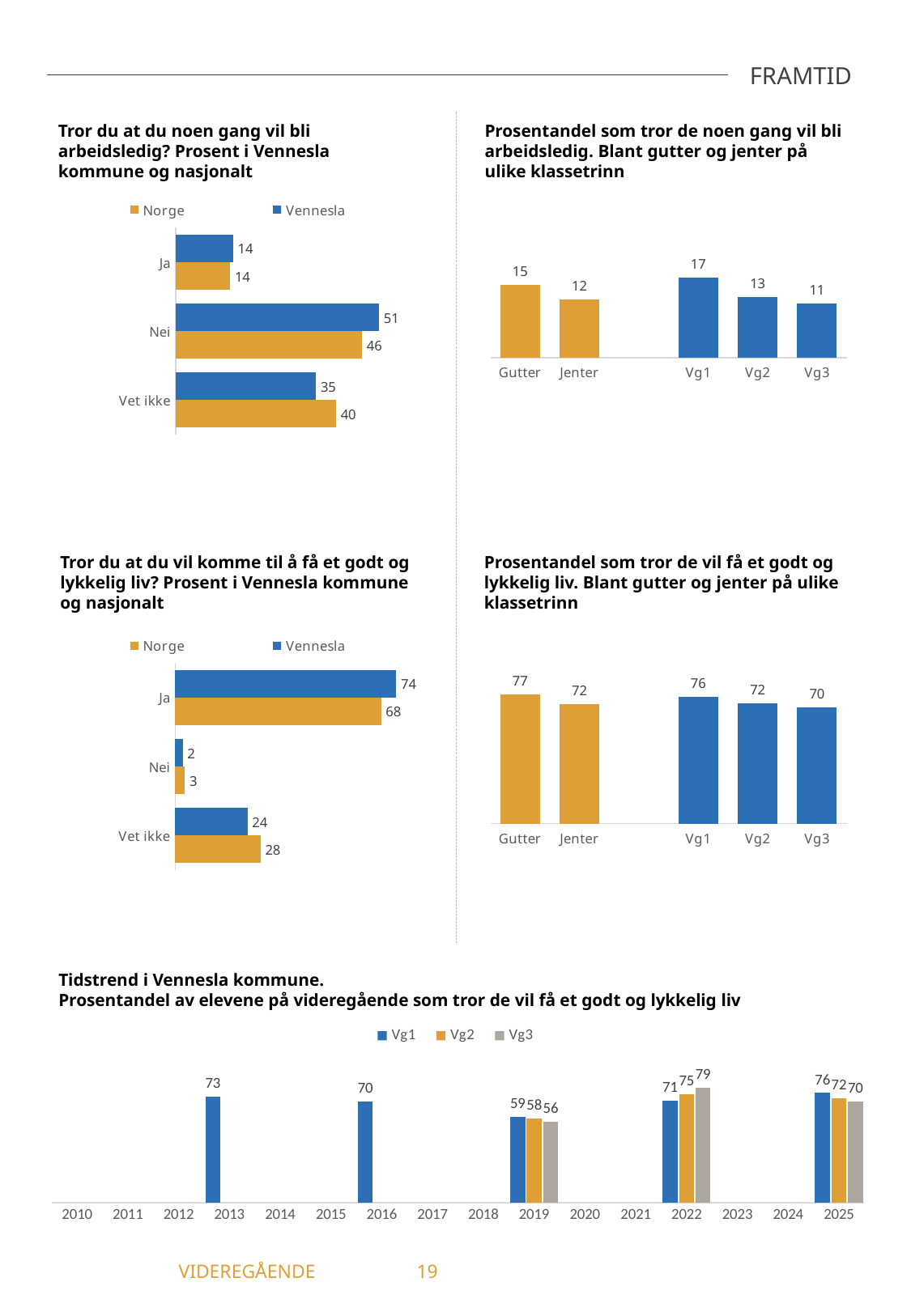
In the chart 'Tror du at du vil komme til å få et godt og lykkelig liv? Prosent i Vennesla kommune og nasjonalt', which is larger for 'Vet ikke': Norge or Vennesla? Norge In the bottom chart 'Tidstrend i Vennesla kommune', what is the value for Vg3 in 2022? 79 In the chart 'Prosentandel som tror de noen gang vil bli arbeidsledig. Blant gutter og jenter på ulike klassetrinn', what is the value for Jenter? 12 What kind of chart is the bottom chart 'Tidstrend i Vennesla kommune'? Bar chart In the bottom chart 'Tidstrend i Vennesla kommune', how many series does the legend list? 3 In the chart 'Tror du at du noen gang vil bli arbeidsledig? Prosent i Vennesla kommune og nasjonalt', how many series does the legend list? 2 In the chart 'Tror du at du noen gang vil bli arbeidsledig? Prosent i Vennesla kommune og nasjonalt', what is the difference between Norge and Vennesla for 'Vet ikke'? 5 In the chart 'Tror du at du vil komme til å få et godt og lykkelig liv? Prosent i Vennesla kommune og nasjonalt', what is the value for Norge for 'Ja'? 68 In the chart 'Prosentandel som tror de noen gang vil bli arbeidsledig. Blant gutter og jenter på ulike klassetrinn', which category has the highest value? Vg1 In the chart 'Prosentandel som tror de vil få et godt og lykkelig liv. Blant gutter og jenter på ulike klassetrinn', what is the difference between Gutter and Jenter? 5 In the chart 'Tror du at du noen gang vil bli arbeidsledig? Prosent i Vennesla kommune og nasjonalt', what is the value for Vennesla for 'Nei'? 51 In the chart 'Prosentandel som tror de vil få et godt og lykkelig liv. Blant gutter og jenter på ulike klassetrinn', which category has the lowest value? Vg3